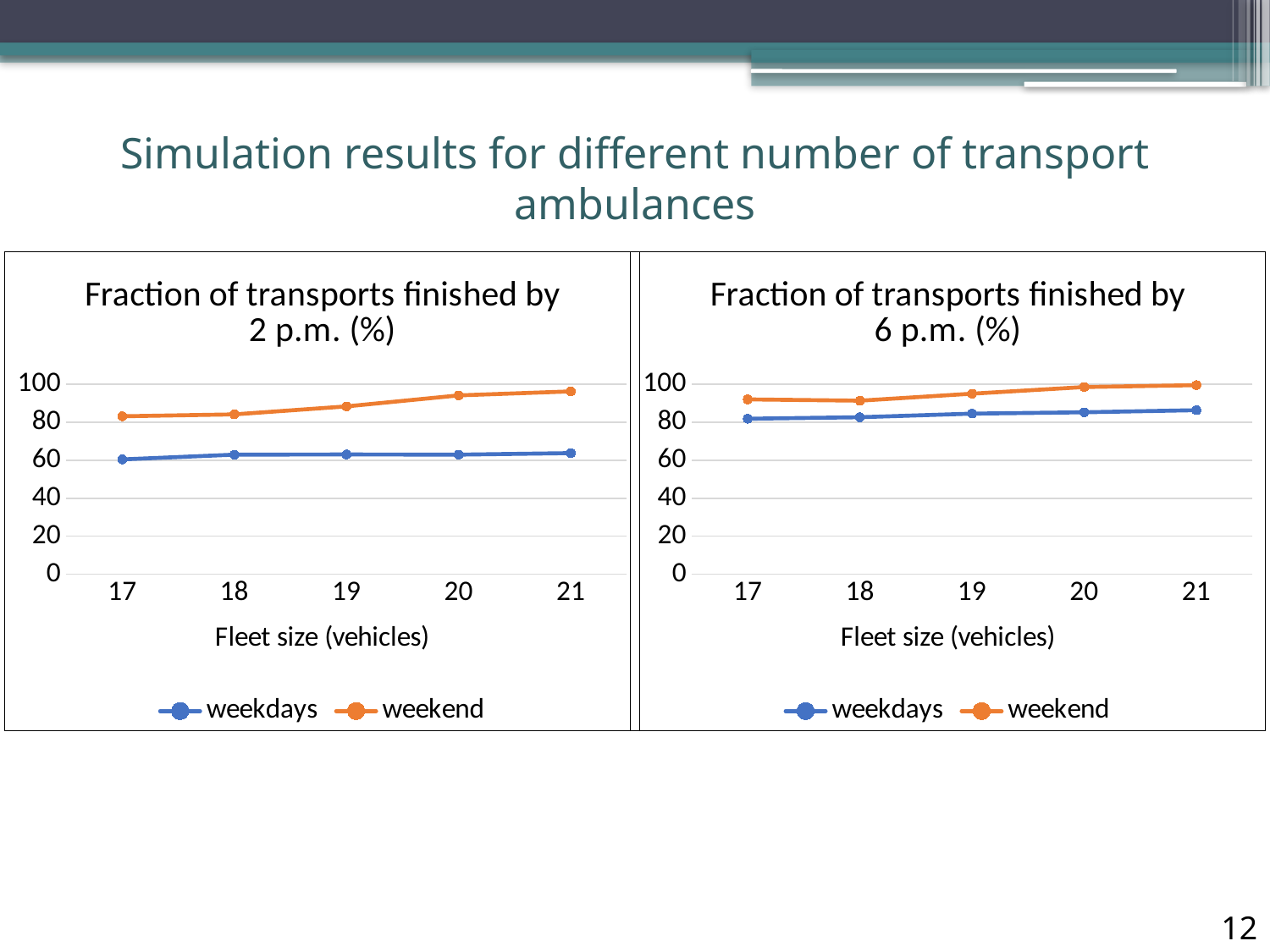
In the 'Fraction of transports finished by 2 p.m. (%)' chart, is the weekend value at fleet size 21 greater or less than 80? greater How many fleet sizes are plotted on the x axis of the 'Fraction of transports finished by 2 p.m. (%)' chart? 5 What kind of chart is the 'Fraction of transports finished by 2 p.m. (%)' chart? line chart What is the x-axis label of the 'Fraction of transports finished by 6 p.m. (%)' chart? Fleet size (vehicles) In the 'Fraction of transports finished by 2 p.m. (%)' chart, which colour is used for the weekend series? orange In the 'Fraction of transports finished by 6 p.m. (%)' chart, which series has the larger value at fleet size 17, weekdays or weekend? weekend In the 'Fraction of transports finished by 2 p.m. (%)' chart, which series has the larger value at fleet size 19, weekdays or weekend? weekend In the 'Fraction of transports finished by 6 p.m. (%)' chart, does the weekdays series rise or fall as fleet size increases from 17 to 21? rise In the 'Fraction of transports finished by 2 p.m. (%)' chart, is the weekdays value at fleet size 17 greater or less than 80? less In the 'Fraction of transports finished by 6 p.m. (%)' chart, is the weekdays value at fleet size 17 greater or less than 60? greater In the 'Fraction of transports finished by 2 p.m. (%)' chart, does the weekend series rise or fall as fleet size increases from 17 to 21? rise How many series does the legend of the 'Fraction of transports finished by 6 p.m. (%)' chart list? 2